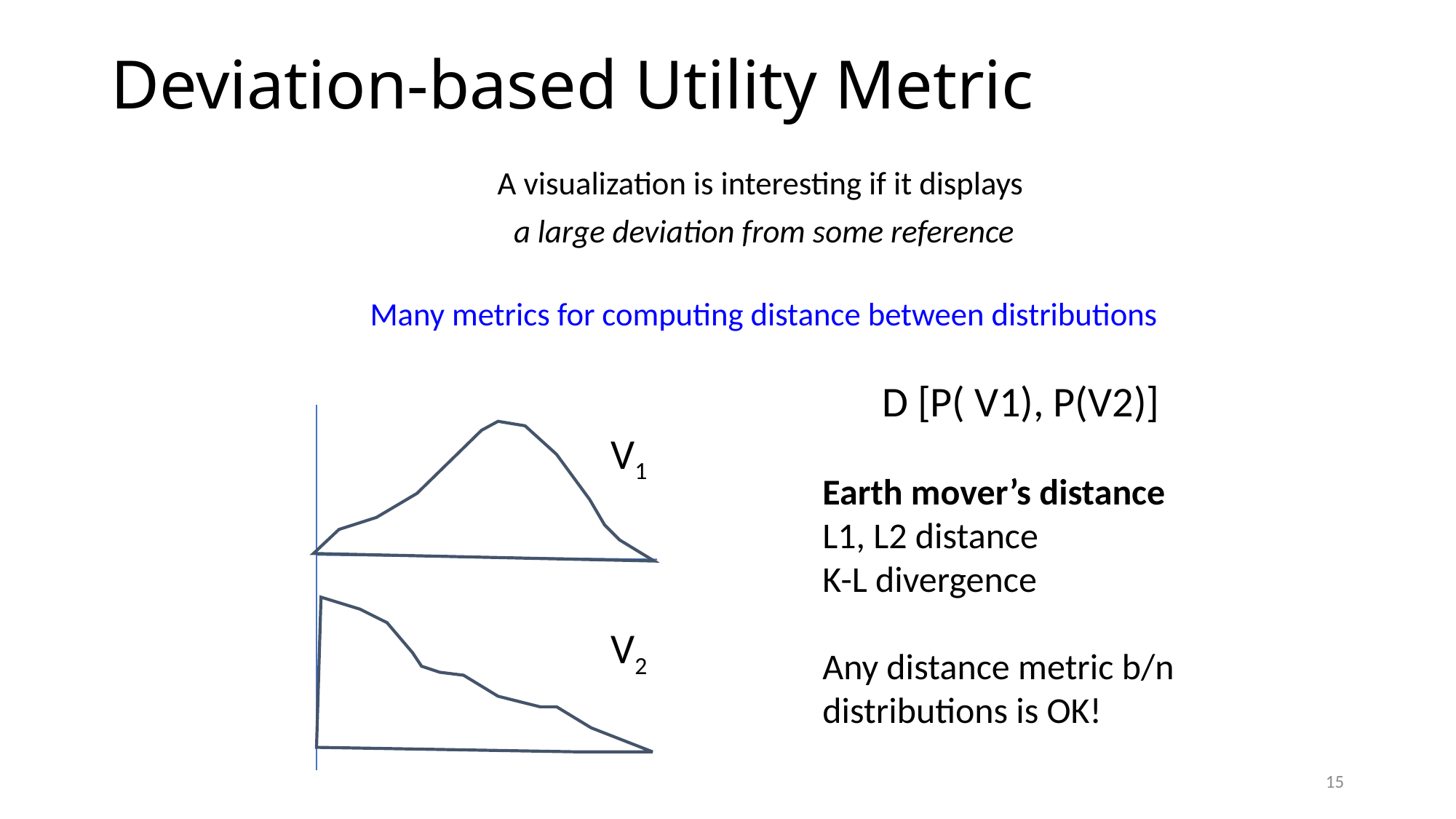
What are the labels of the two charts on the slide? V1 and V2 In the upper chart labelled V1, do the values rise then fall, or fall then rise, along the x axis? rise then fall What kind of chart is the upper sketch labelled V1? line chart How many charts (distribution sketches) are shown on the slide? 2 In the lower chart labelled V2, do the values rise or fall along the x axis? fall In the lower chart labelled V2, is the value at the left end of the curve higher or lower than the value at the right end? higher